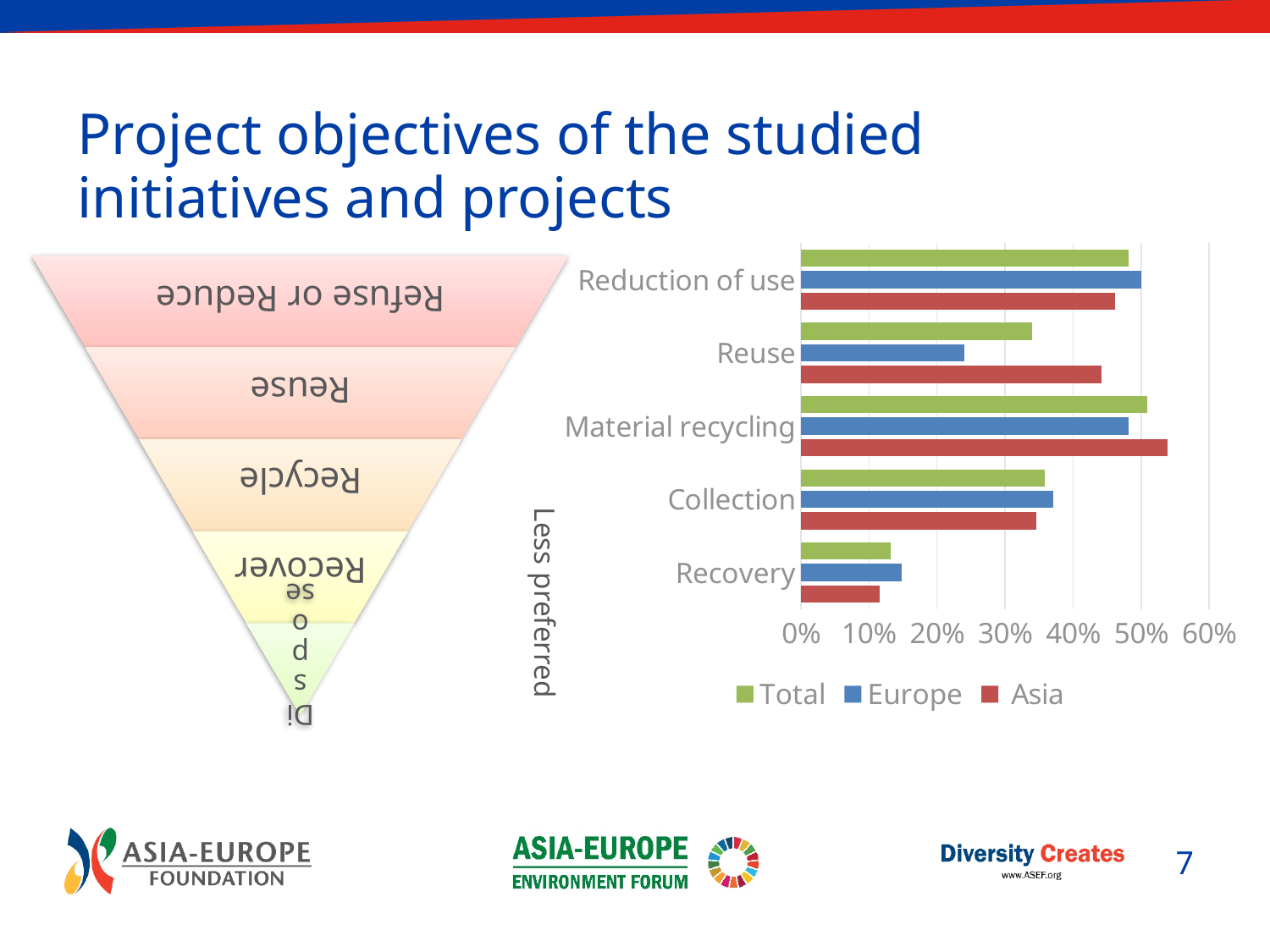
Which series are listed in the legend of the bar chart? Total, Europe, Asia How many series does the legend of the bar chart list? 3 Is the Asia value for Material recycling greater or less than 50%? greater Is the Asia value for Recovery greater or less than 20%? less What kind of chart is shown on the right side of the slide? bar chart Is the Asia value for Reuse greater or less than 40%? greater For Recovery, which is larger: the Europe value or the Asia value? Europe How many categories are plotted on the bar chart? 5 Which category has the lowest Total value? Recovery For Reuse, which is larger: the Europe value or the Asia value? Asia Which category has the highest Asia value? Material recycling